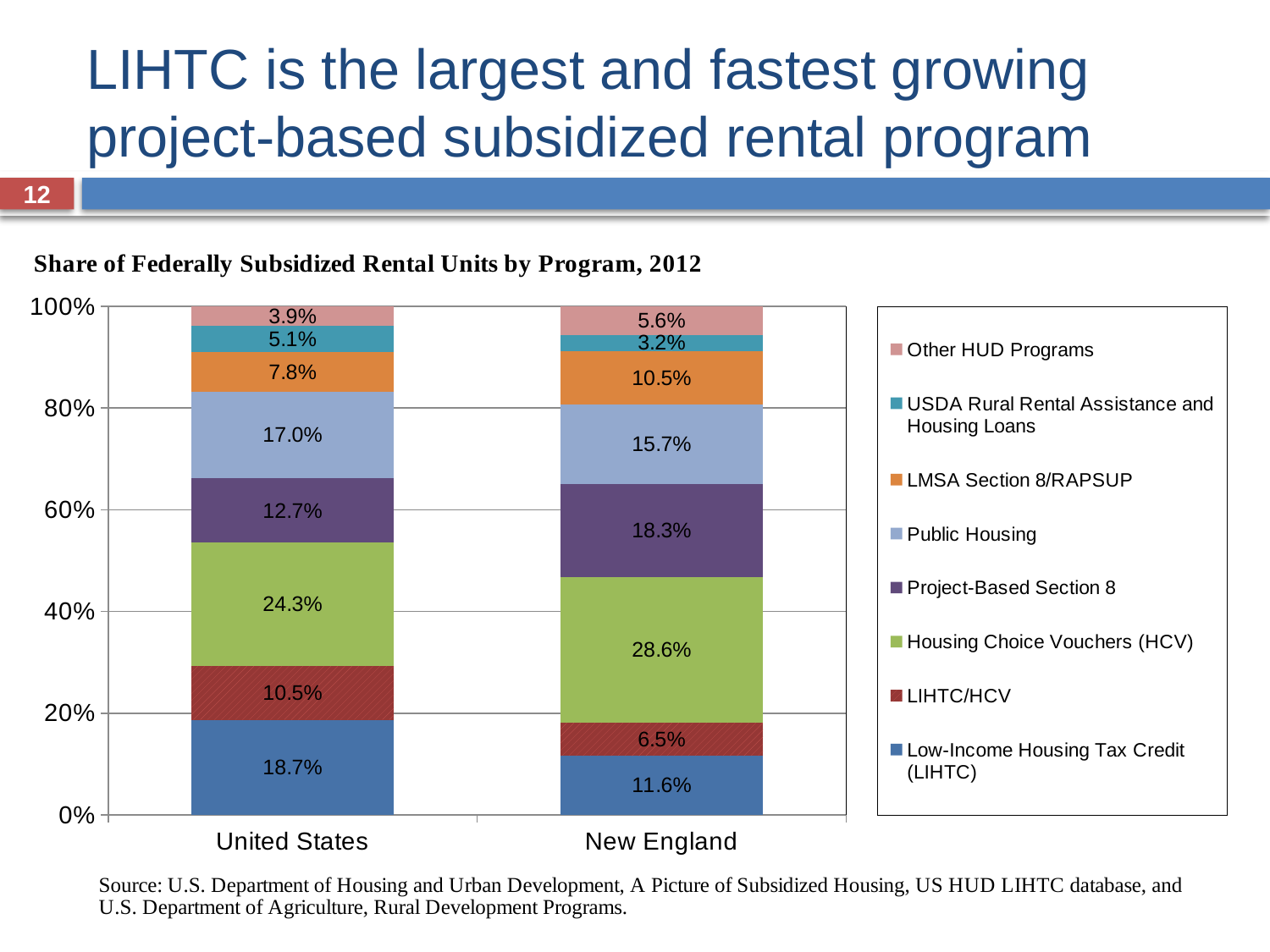
Which region has a larger share of LMSA Section 8/RAPSUP units, the United States or New England? New England How many programs (series) does the legend list? 8 What is the share of Low-Income Housing Tax Credit (LIHTC) units in the United States? 18.7% How many regions (categories) are shown on the x axis? 2 Which program has the smallest share of federally subsidized rental units in New England? USDA Rural Rental Assistance and Housing Loans What is the share of Public Housing units in the United States? 17.0% What is the share of Housing Choice Vouchers (HCV) units in New England? 28.6% What is the share of Project-Based Section 8 units in New England? 18.3% Which program has the largest share of federally subsidized rental units in the United States? Housing Choice Vouchers (HCV) What kind of chart is shown on the slide? Stacked bar chart What is the title of the chart? Share of Federally Subsidized Rental Units by Program, 2012 What is the difference between the LIHTC share in the United States and in New England? 7.1%